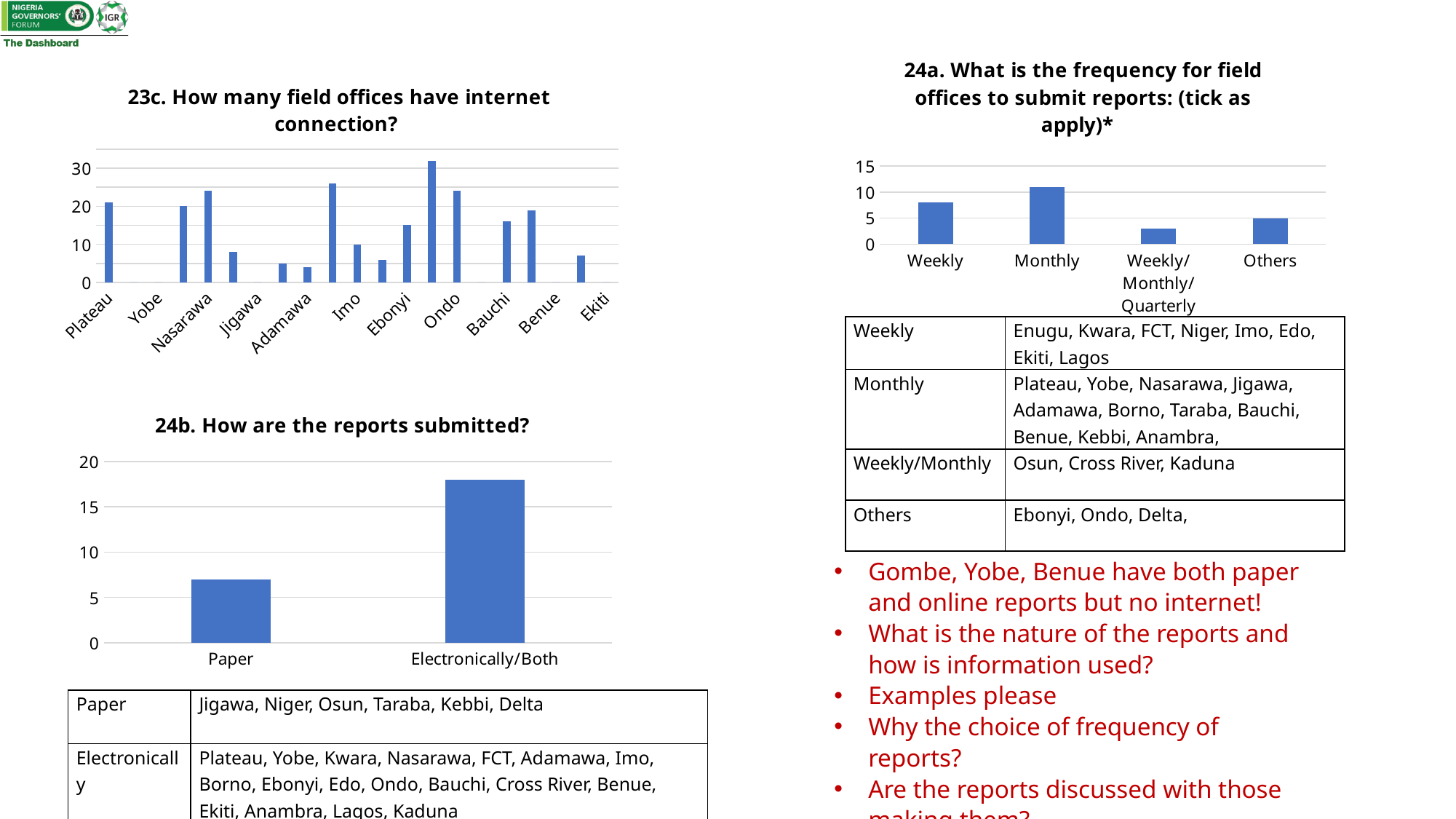
In the chart '23c. How many field offices have internet connection?', is the value for Plateau greater or less than 10? greater In the chart '24b. How are the reports submitted?', how many categories are shown on the x axis? 2 In the chart '24a. What is the frequency for field offices to submit reports', is the value for Weekly/Monthly/Quarterly greater or less than 5? less In the chart '24a. What is the frequency for field offices to submit reports', which category has the lowest bar? Weekly/Monthly/Quarterly In the chart '24b. How are the reports submitted?', is the value for Paper greater or less than 10? less In the chart '24a. What is the frequency for field offices to submit reports', which is larger, the value for Weekly or the value for Others? Weekly In the chart '24b. How are the reports submitted?', which category has the higher bar? Electronically/Both In the chart '24a. What is the frequency for field offices to submit reports', how many categories are shown on the x axis? 4 In the chart '24a. What is the frequency for field offices to submit reports', which category has the highest bar? Monthly What kind of chart is '23c. How many field offices have internet connection?' bar chart